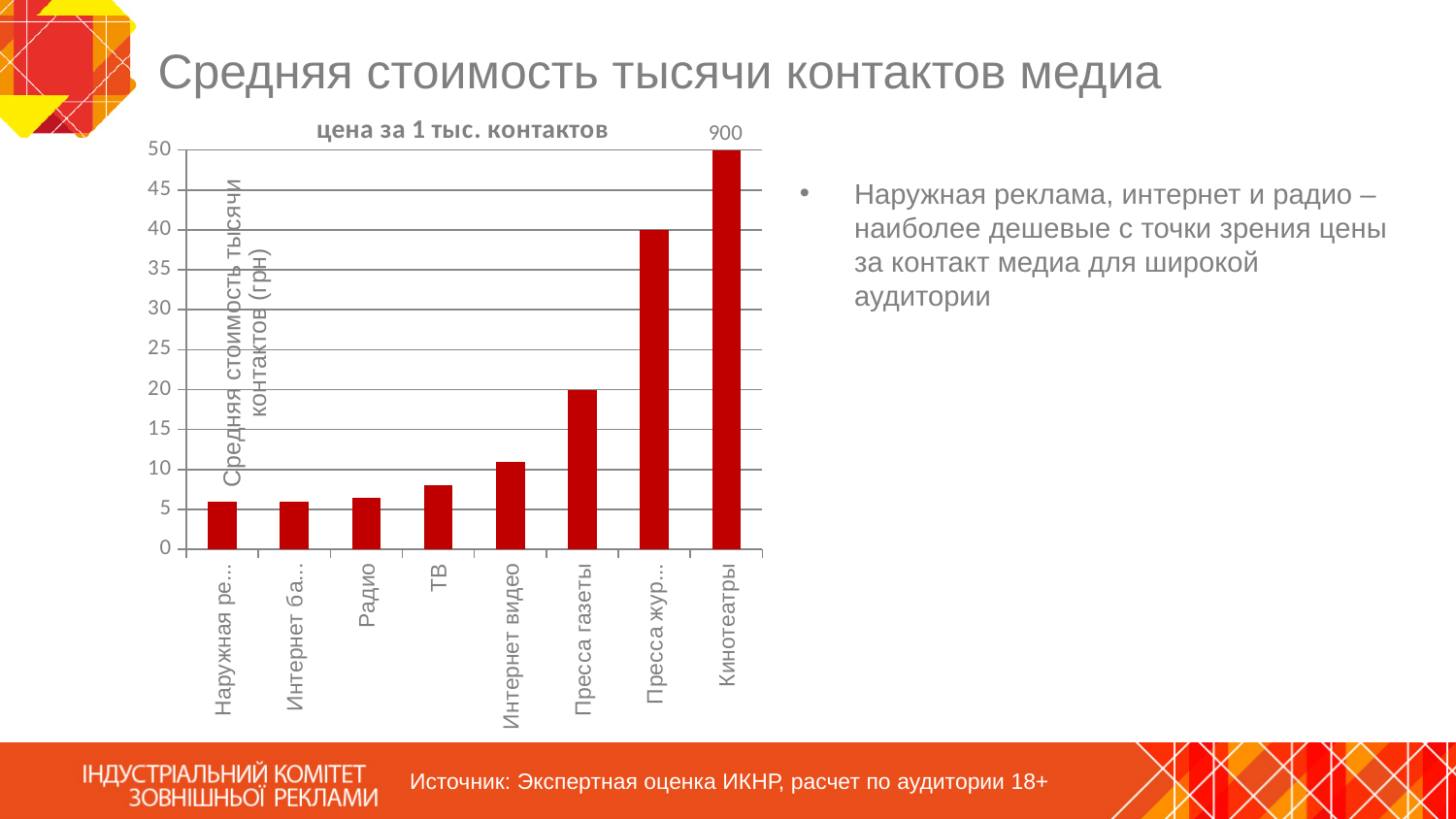
How many categories are plotted on the x axis of the chart? 8 Is the value for Радио greater or less than 10? less Is the value for Пресса газеты greater or less than 15? greater Is the value for ТВ greater or less than 10? less What value is printed for Кинотеатры? 900 Do the values rise or fall moving from left to right along the x axis? rise Which is larger, the value for Интернет видео or the value for Радио? Интернет видео Which category has the highest value in the chart? Кинотеатры What is the title of the chart? цена за 1 тыс. контактов Which is larger, the value for Пресса газеты or the value for ТВ? Пресса газеты What kind of chart is shown on the slide? bar chart